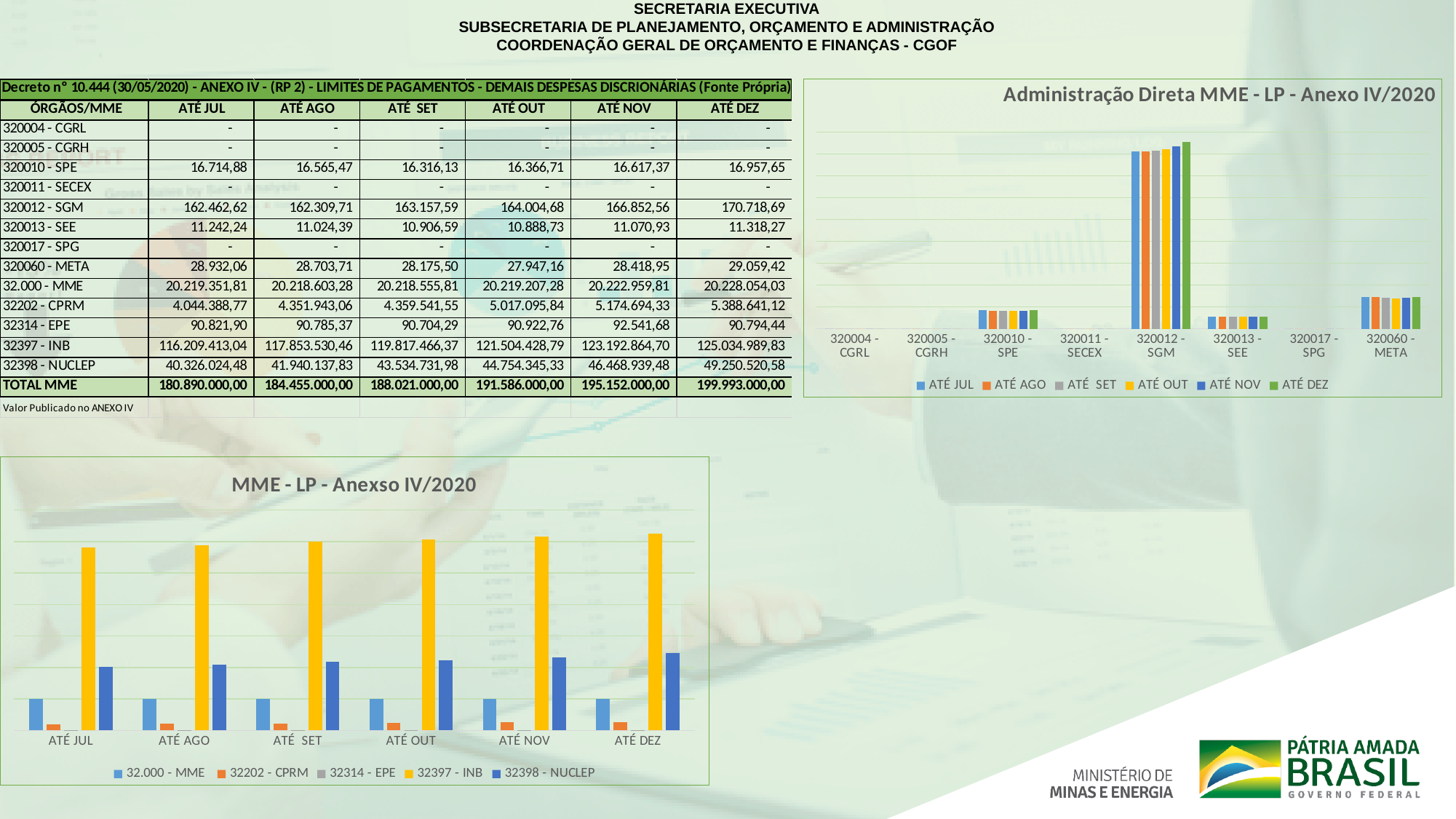
In the 'MME - LP - Anexso IV/2020' chart, which series has the tallest bars in every category? 32397 - INB How many categories are shown on the x axis of the 'Administração Direta MME - LP - Anexo IV/2020' chart? 8 In the 'Administração Direta MME - LP - Anexo IV/2020' chart, which is larger for ATÉ DEZ: 320060 - META or 320013 - SEE? 320060 - META What kind of chart is the 'Administração Direta MME - LP - Anexo IV/2020' chart? bar chart How many series does the legend of the 'MME - LP - Anexso IV/2020' chart list? 5 What kind of chart is the 'MME - LP - Anexso IV/2020' chart? bar chart In the 'MME - LP - Anexso IV/2020' chart, do the 32397 - INB bars rise or fall from ATÉ JUL to ATÉ DEZ? rise In the 'Administração Direta MME - LP - Anexo IV/2020' chart, what colour are the ATÉ DEZ bars? green How many series does the legend of the 'Administração Direta MME - LP - Anexo IV/2020' chart list? 6 In the 'Administração Direta MME - LP - Anexo IV/2020' chart, which category has the highest bars? 320012 - SGM How many categories are shown on the x axis of the 'MME - LP - Anexso IV/2020' chart? 6 In the 'Administração Direta MME - LP - Anexo IV/2020' chart, which is larger for ATÉ JUL: 320010 - SPE or 320013 - SEE? 320010 - SPE